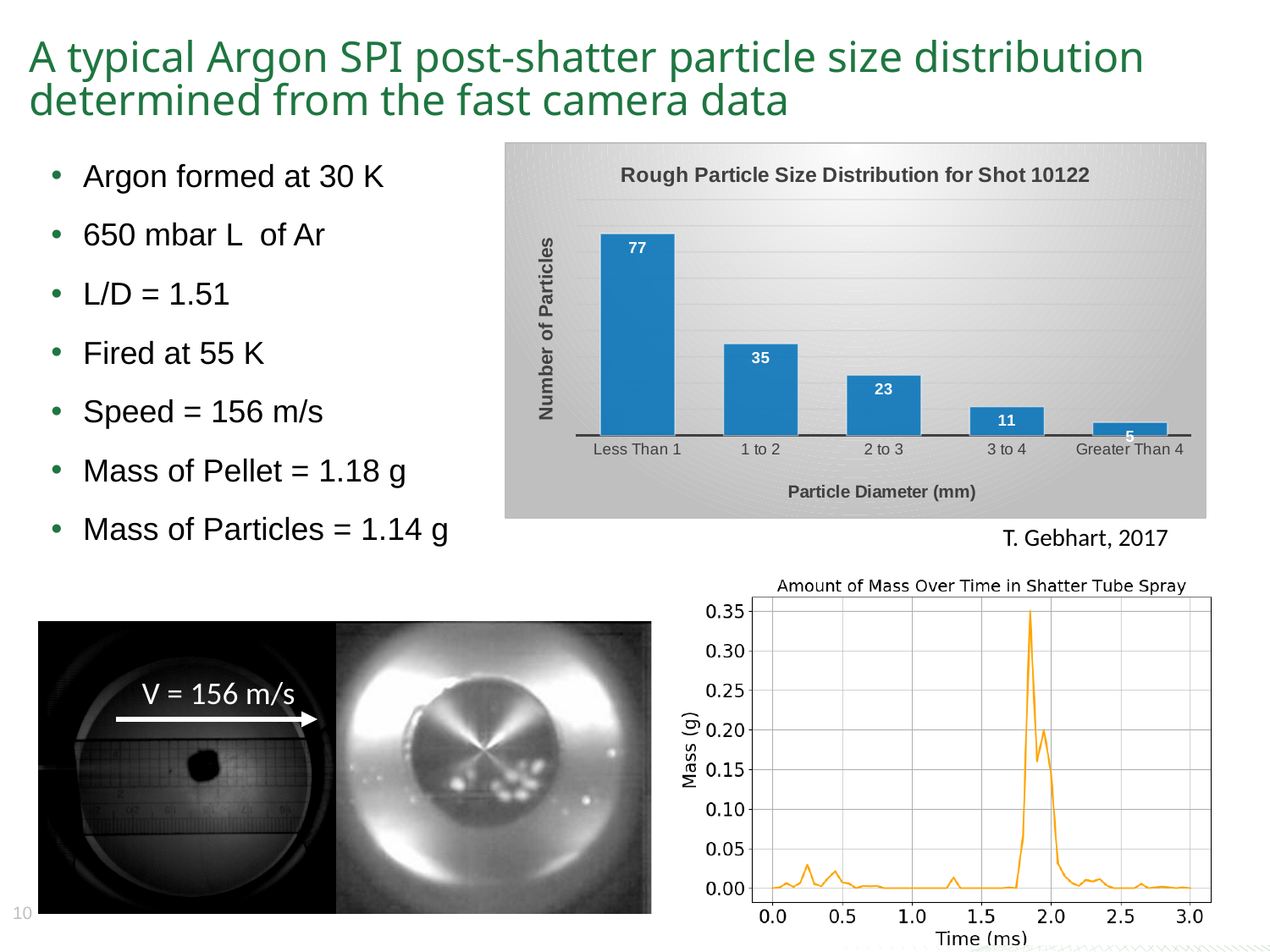
What kind of chart is "Amount of Mass Over Time in Shatter Tube Spray"? Line chart In the chart titled "Rough Particle Size Distribution for Shot 10122", how many particles are in the "Less Than 1" mm category? 77 In the chart titled "Rough Particle Size Distribution for Shot 10122", do the values rise or fall as particle diameter increases along the x axis? Fall In the chart titled "Rough Particle Size Distribution for Shot 10122", which particle diameter category has the lowest number of particles? Greater Than 4 What kind of chart is "Rough Particle Size Distribution for Shot 10122"? Bar chart In the chart titled "Rough Particle Size Distribution for Shot 10122", what is the total number of particles across all categories? 151 In the chart titled "Rough Particle Size Distribution for Shot 10122", which particle diameter category has the highest number of particles? Less Than 1 In the chart titled "Rough Particle Size Distribution for Shot 10122", which has more particles: "3 to 4" or "Greater Than 4"? 3 to 4 In the chart titled "Rough Particle Size Distribution for Shot 10122", what is the difference between the number of particles in the "Less Than 1" and "1 to 2" categories? 42 In the chart titled "Rough Particle Size Distribution for Shot 10122", how many particles are in the "2 to 3" mm category? 23 In the chart titled "Rough Particle Size Distribution for Shot 10122", how many particle diameter categories are shown? 5 In the chart titled "Amount of Mass Over Time in Shatter Tube Spray", is the peak mass value greater or less than 0.30 g? greater